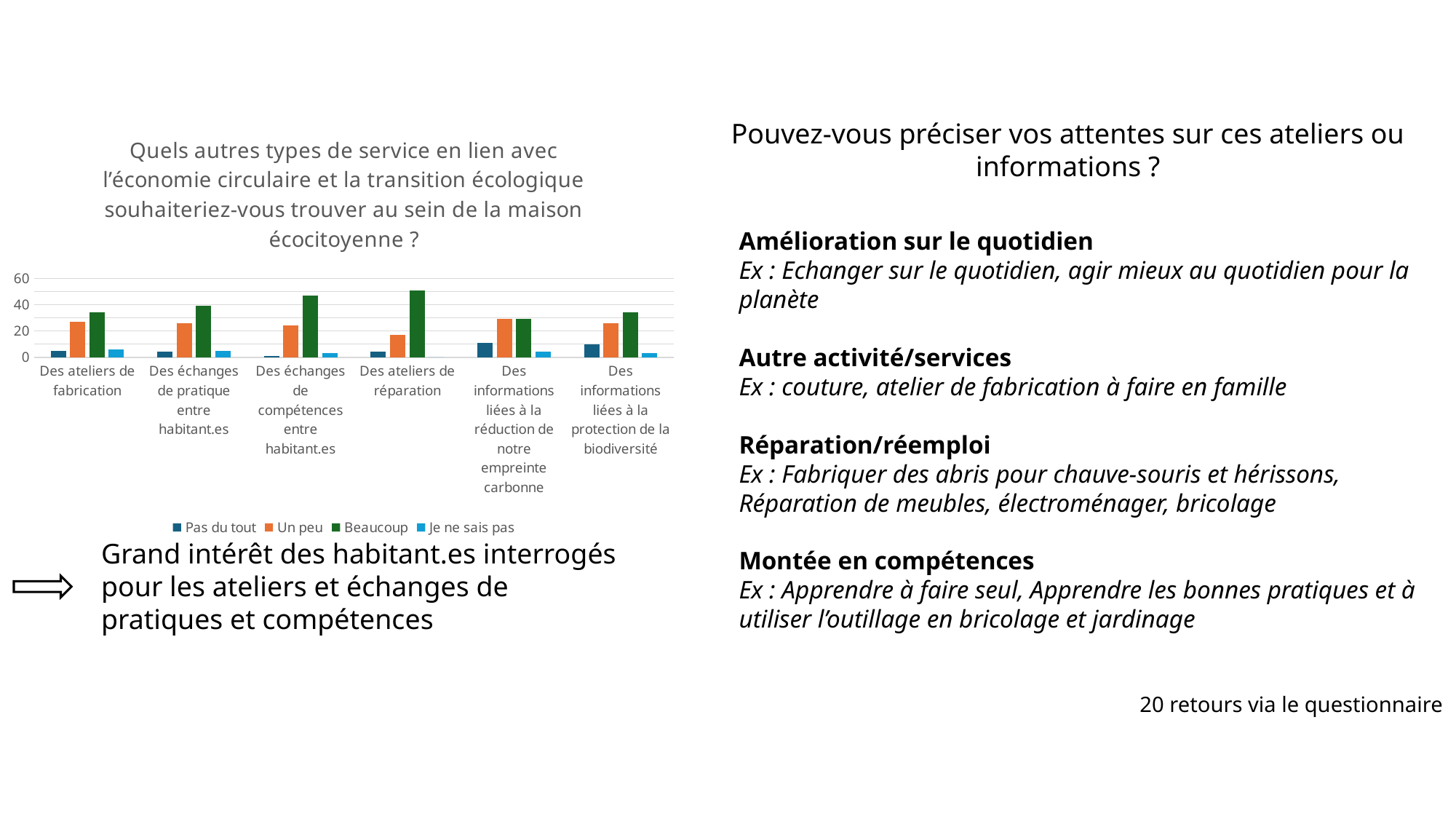
Which has the larger 'Pas du tout' value: 'Des ateliers de fabrication' or 'Des informations liées à la réduction de notre empreinte carbone'? Des informations liées à la réduction de notre empreinte carbone How many categories are shown on the x axis of the chart? 6 What are the four series listed in the chart's legend? Pas du tout, Un peu, Beaucoup, Je ne sais pas How many series does the chart's legend list? 4 Is the 'Beaucoup' value for 'Des ateliers de fabrication' greater or less than 40? less For 'Des ateliers de fabrication', which is larger: the 'Un peu' bar or the 'Beaucoup' bar? Beaucoup Is the 'Un peu' value for 'Des ateliers de réparation' greater or less than 20? less Is the 'Beaucoup' value for 'Des échanges de compétences entre habitant.es' greater or less than 40? greater For 'Des ateliers de réparation', which series has the lowest value? Je ne sais pas Which category has the tallest 'Beaucoup' bar? Des ateliers de réparation What kind of chart is shown on the left of the slide? bar chart